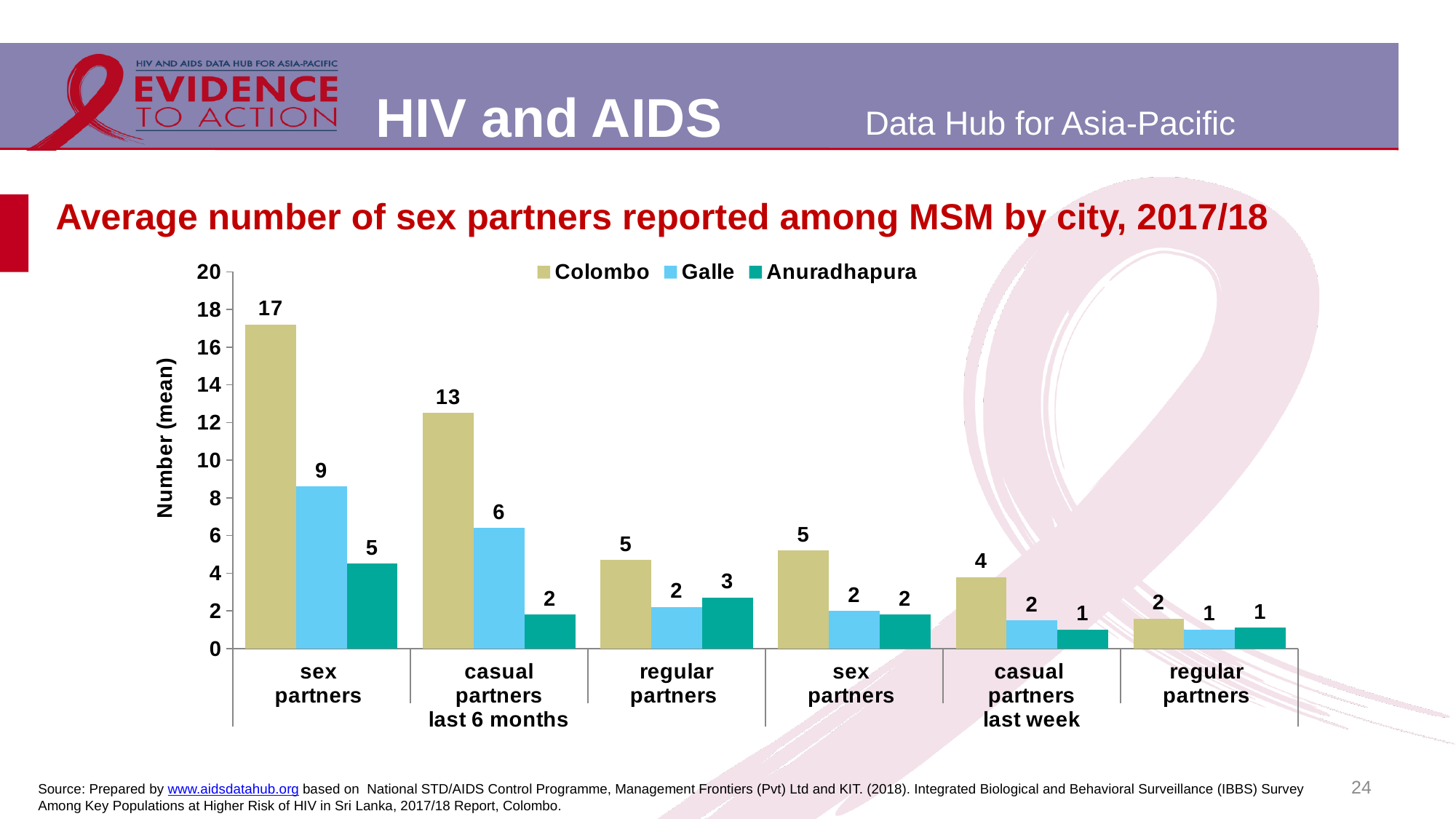
What kind of chart is shown on the slide? Bar chart What is the value for Galle for casual partners in the last 6 months? 6 How many series does the legend list? 3 What is the value for Colombo for casual partners in the last week? 4 What is the label of the y axis? Number (mean) What is the difference between the Colombo and Galle values for sex partners in the last 6 months? 8 For regular partners in the last 6 months, which is larger: the value for Galle or the value for Anuradhapura? Anuradhapura What is the value for Anuradhapura for regular partners in the last 6 months? 3 What is the value for Colombo for sex partners in the last 6 months? 17 Is the value for Colombo for casual partners in the last 6 months greater or less than 10? greater Which city has the lowest value for casual partners in the last 6 months? Anuradhapura Which city has the highest value for sex partners in the last 6 months? Colombo